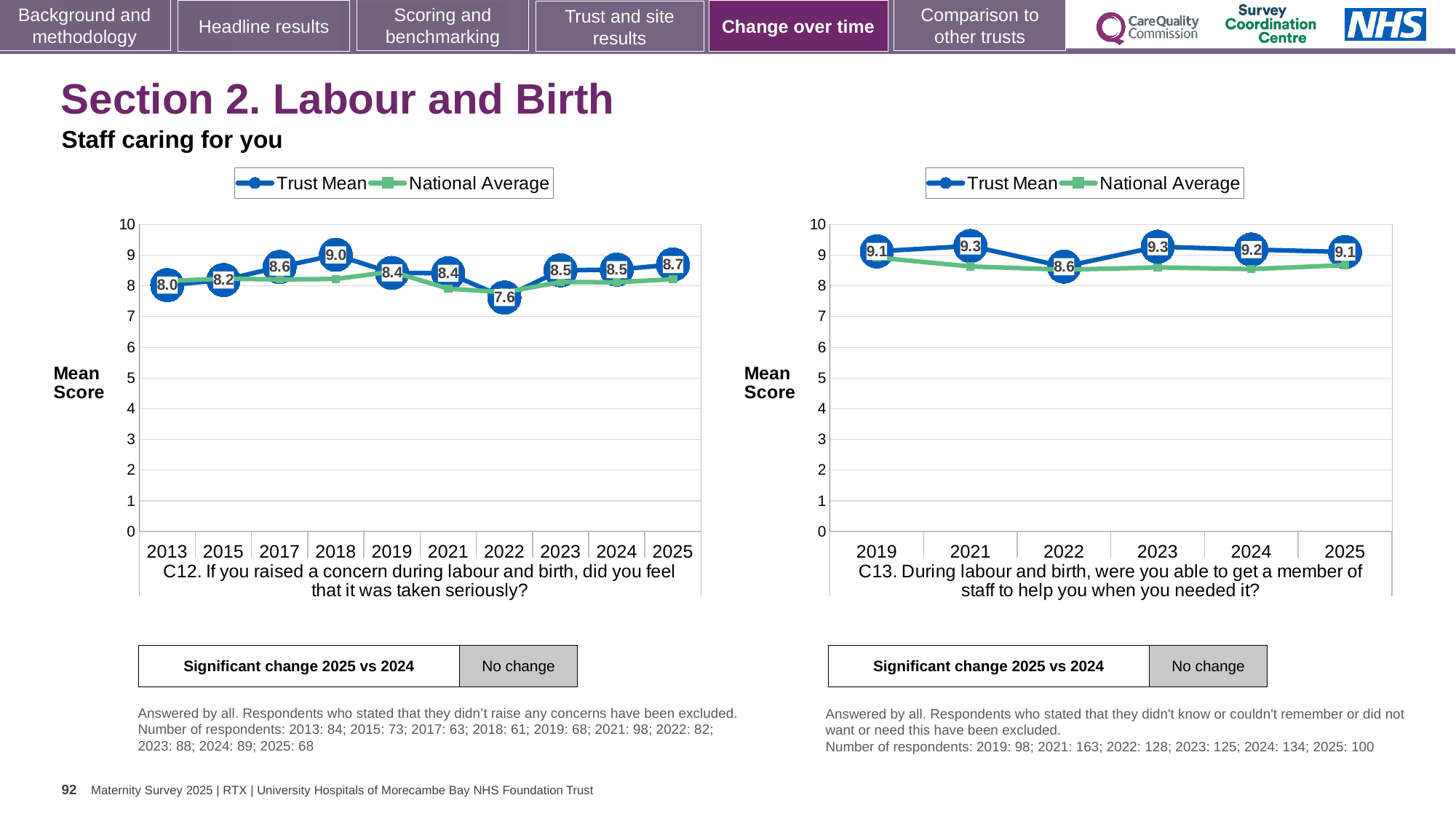
What type of chart is the C12 chart (left)? Line chart In the C12 chart (left), what is the Trust Mean score for 2025? 8.7 In the C12 chart (left), what is the Trust Mean score for 2022? 7.6 In the C13 chart (right), what is the Trust Mean score for 2022? 8.6 In the C13 chart (right), which year has the lowest Trust Mean score? 2022 In the C12 chart (left), which year has the highest Trust Mean score? 2018 In the C13 chart (right), is the Trust Mean score for 2021 larger or smaller than the score for 2024? larger In the C12 chart (left), what is the difference between the Trust Mean scores for 2018 and 2022? 1.4 In the C13 chart (right), is the National Average value for 2019 greater or less than 8? greater How many series does the legend of the C13 chart (right) list? 2 In the C12 chart (left), which year has the lowest Trust Mean score? 2022 How many years are plotted on the x axis of the C12 chart (left)? 10